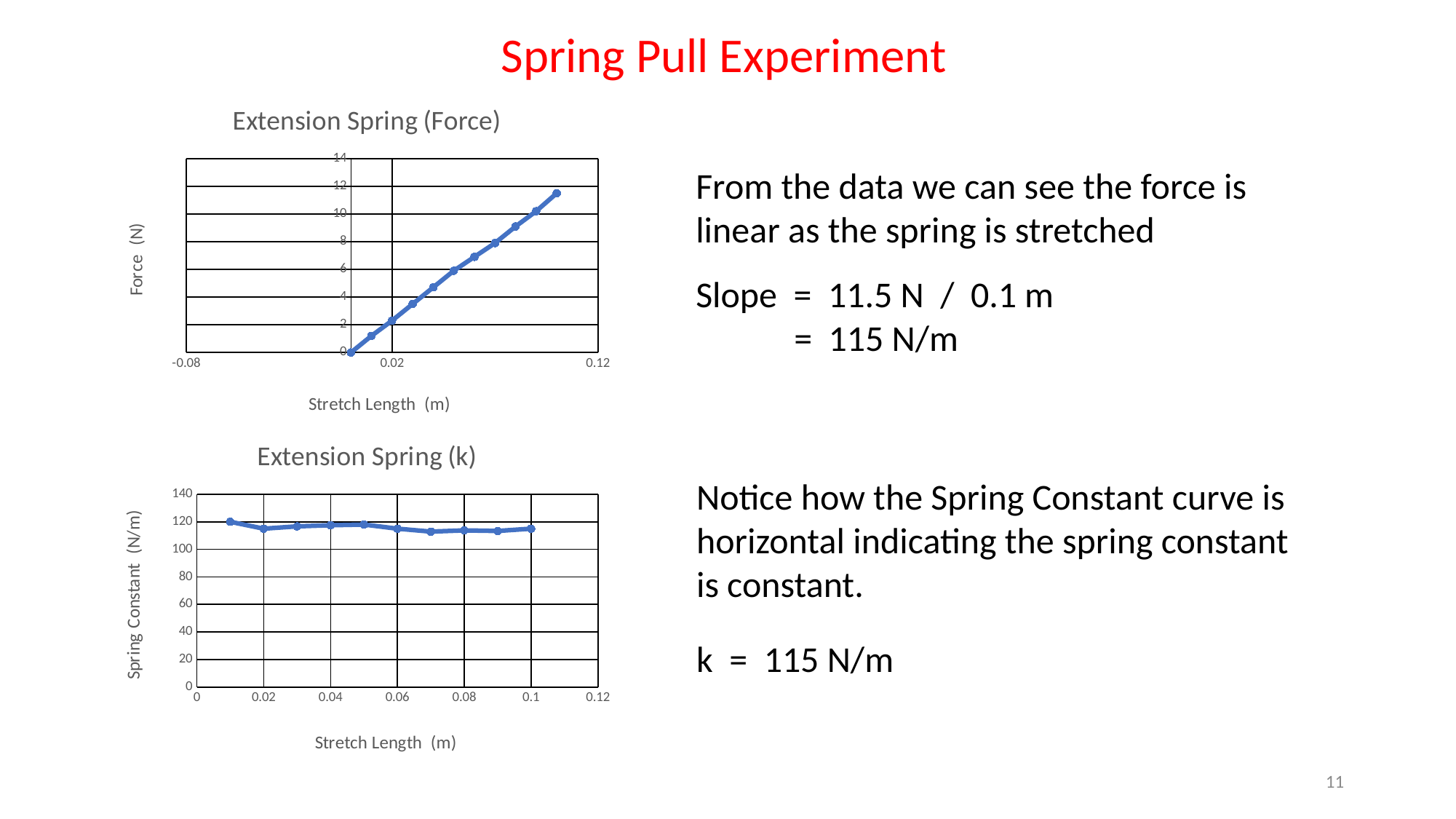
What kind of chart is the 'Extension Spring (k)' chart? line chart In the 'Extension Spring (k)' chart, is the spring constant at a stretch length of 0.1 m greater or less than 140? less In the 'Extension Spring (Force)' chart, is the force at a stretch length of 0.02 m greater or less than 4? less In the 'Extension Spring (Force)' chart, is the force at a stretch length of 0.1 m larger or smaller than the force at 0.02 m? larger What is the x-axis label of the 'Extension Spring (Force)' chart? Stretch Length (m) In the 'Extension Spring (Force)' chart, is the force at the largest stretch length greater or less than 10? greater In the 'Extension Spring (Force)' chart, do the force values rise or fall as stretch length increases? rise In the 'Extension Spring (k)' chart, at which stretch length is the spring constant highest? 0.01 In the 'Extension Spring (k)' chart, how many data points are plotted? 10 What is the y-axis label of the 'Extension Spring (k)' chart? Spring Constant (N/m) What kind of chart is the 'Extension Spring (Force)' chart? line chart